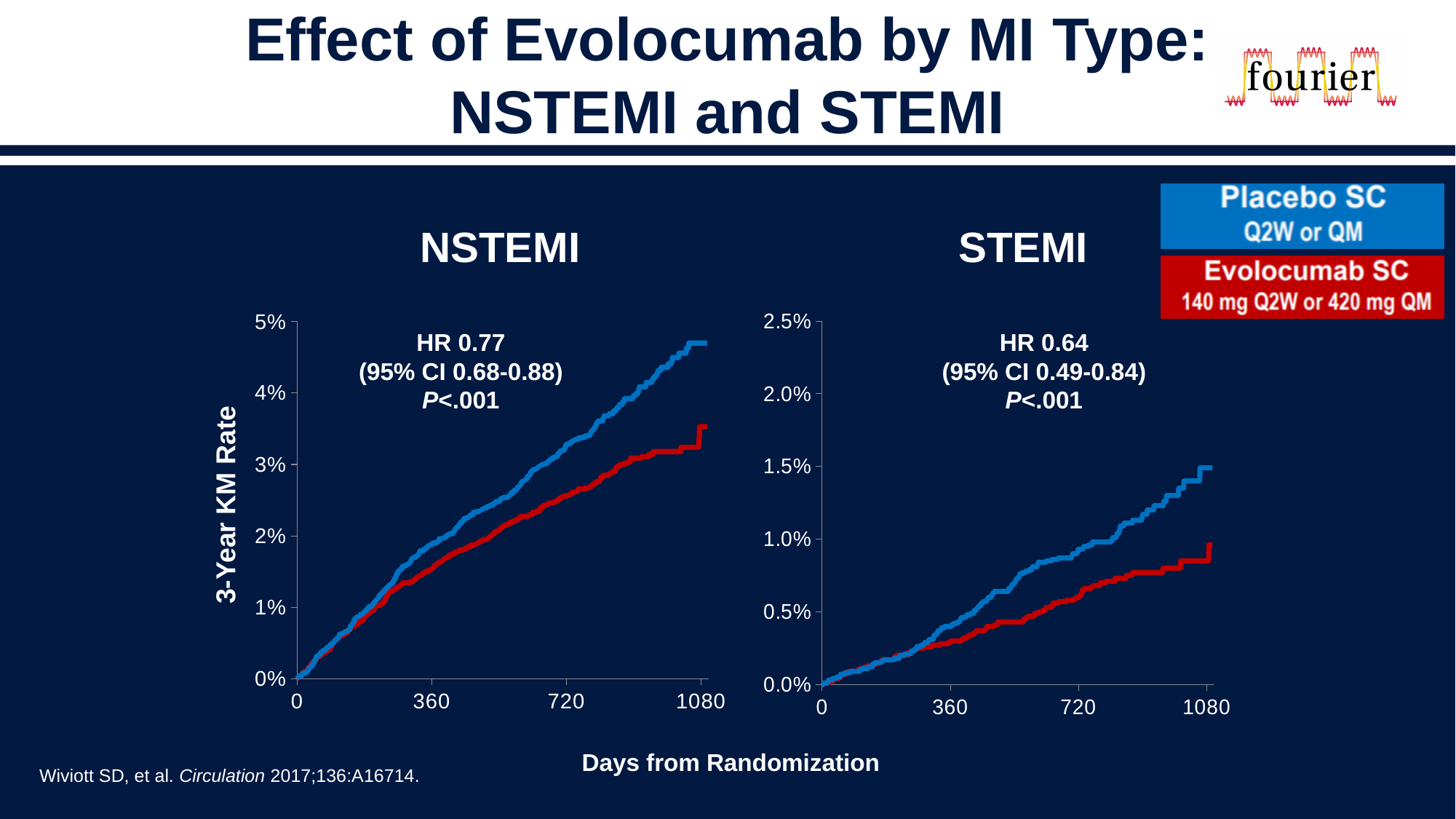
In the STEMI chart, which series has the higher value at 1080 days, Placebo SC or Evolocumab SC? Placebo SC In the NSTEMI chart, is the value for Placebo SC at 1080 days greater or less than 4%? greater In the NSTEMI chart, what hazard ratio is printed? HR 0.77 In the NSTEMI chart, is the value for Evolocumab SC at 1080 days greater or less than 4%? less How many labelled tick marks are on the x axis of the STEMI chart? 4 How many series does the legend list for the charts? 2 Which colour represents Evolocumab SC in the charts? red In the STEMI chart, is the value for Evolocumab SC at 1080 days greater or less than 0.5%? greater What kind of chart is the NSTEMI chart? line chart In the STEMI chart, what 95% confidence interval is printed for the hazard ratio? 0.49-0.84 In the NSTEMI chart, do the curves rise or fall as days from randomization increase? rise